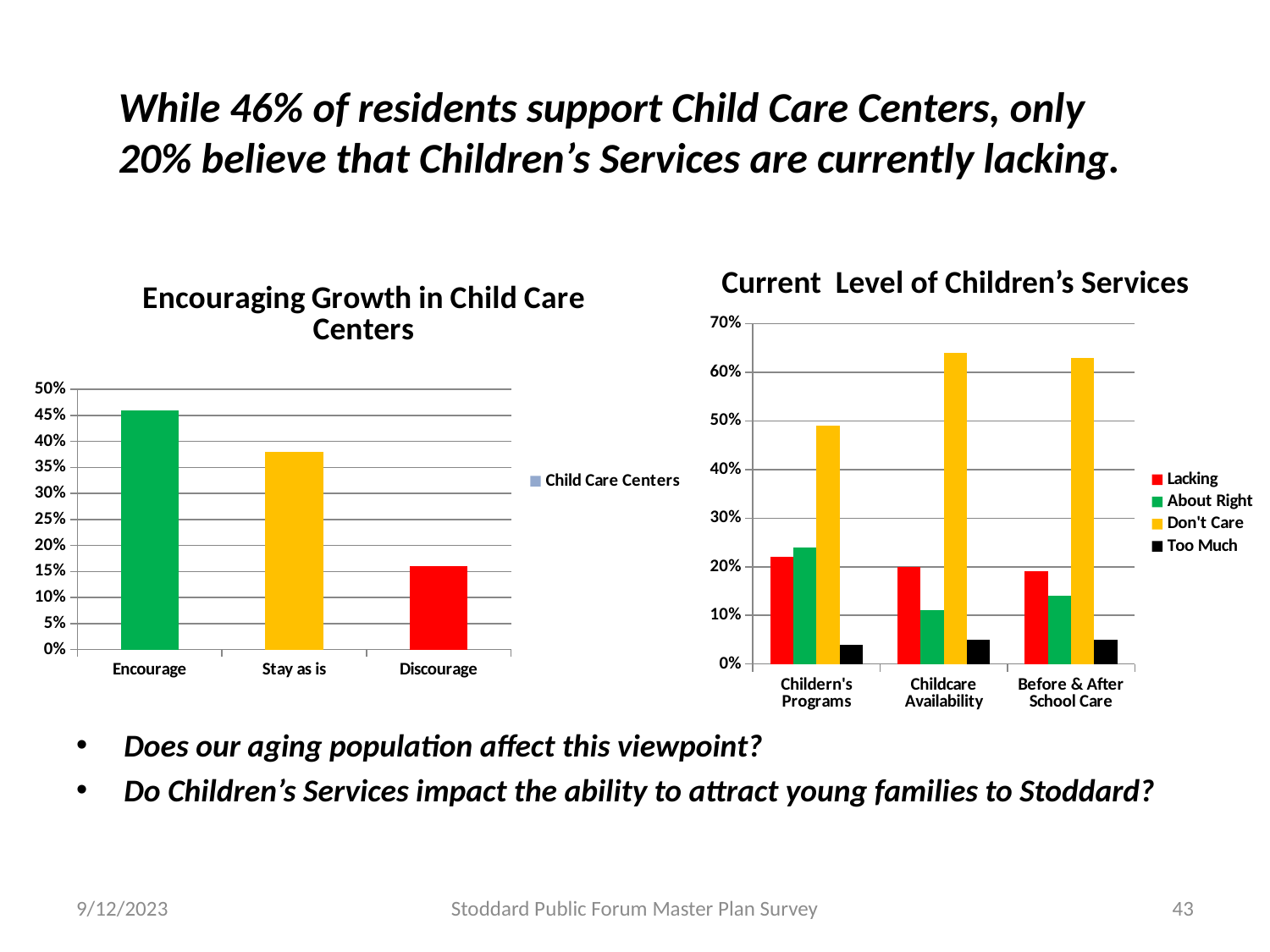
In the 'Encouraging Growth in Child Care Centers' chart, which category has the lowest value? Discourage How many categories are shown on the x axis of the 'Encouraging Growth in Child Care Centers' chart? 3 In the 'Current Level of Children's Services' chart, what colour represents the 'Don't Care' series? yellow In the 'Encouraging Growth in Child Care Centers' chart, which category has the highest value? Encourage In the 'Encouraging Growth in Child Care Centers' chart, is the value for Discourage greater or less than 20%? less In the 'Current Level of Children's Services' chart, which series has the highest value for Childcare Availability? Don't Care What kind of chart is the 'Encouraging Growth in Child Care Centers' chart? bar chart In the 'Current Level of Children's Services' chart, is the 'Don't Care' value larger for Childcare Availability or for Childern's Programs? Childcare Availability How many categories are shown on the x axis of the 'Current Level of Children's Services' chart? 3 In the 'Encouraging Growth in Child Care Centers' chart, is the value for Encourage greater or less than 40%? greater In the 'Current Level of Children's Services' chart, is the 'Don't Care' value for Before & After School Care greater or less than 60%? greater How many series does the legend of the 'Current Level of Children's Services' chart list? 4